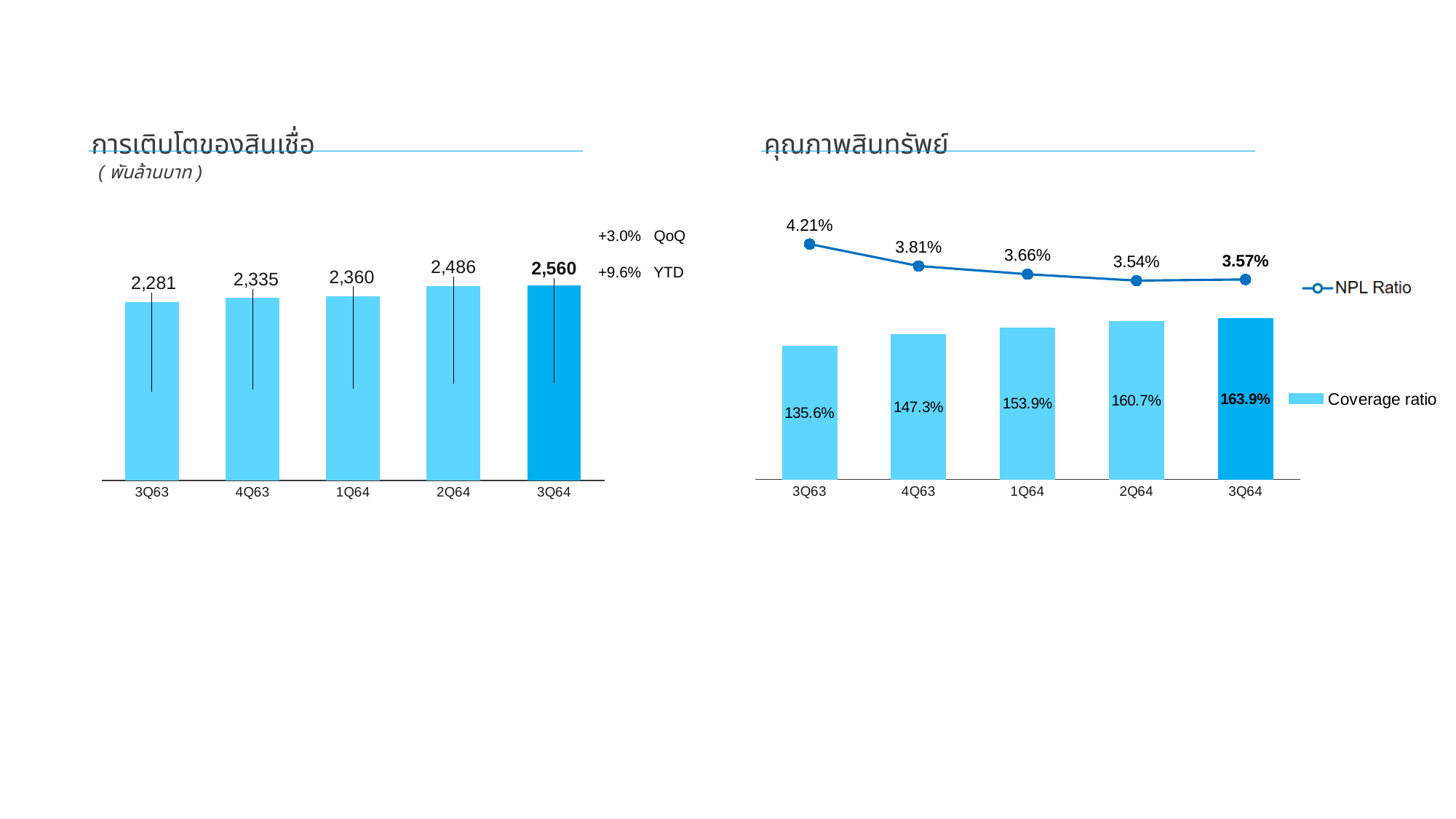
In the left chart, do the values rise or fall from 3Q63 to 3Q64? rise In the right chart, which quarter has the lowest NPL Ratio? 2Q64 In the right chart, what is the NPL Ratio for 1Q64? 3.66% In the left chart, what is the value for 2Q64? 2,486 In the right chart, is the Coverage ratio larger in 2Q64 or in 3Q63? 2Q64 In the left chart, which quarter has the lowest value? 3Q63 In the right chart, what is the Coverage ratio for 4Q63? 147.3% In the right chart, how many series does the legend list? 2 In the left chart, what is the difference between the values for 3Q64 and 3Q63? 279 In the left chart, how many quarters are shown on the x axis? 5 In the right chart, which quarter has the highest Coverage ratio? 3Q64 In the left chart, which quarter has the highest value? 3Q64